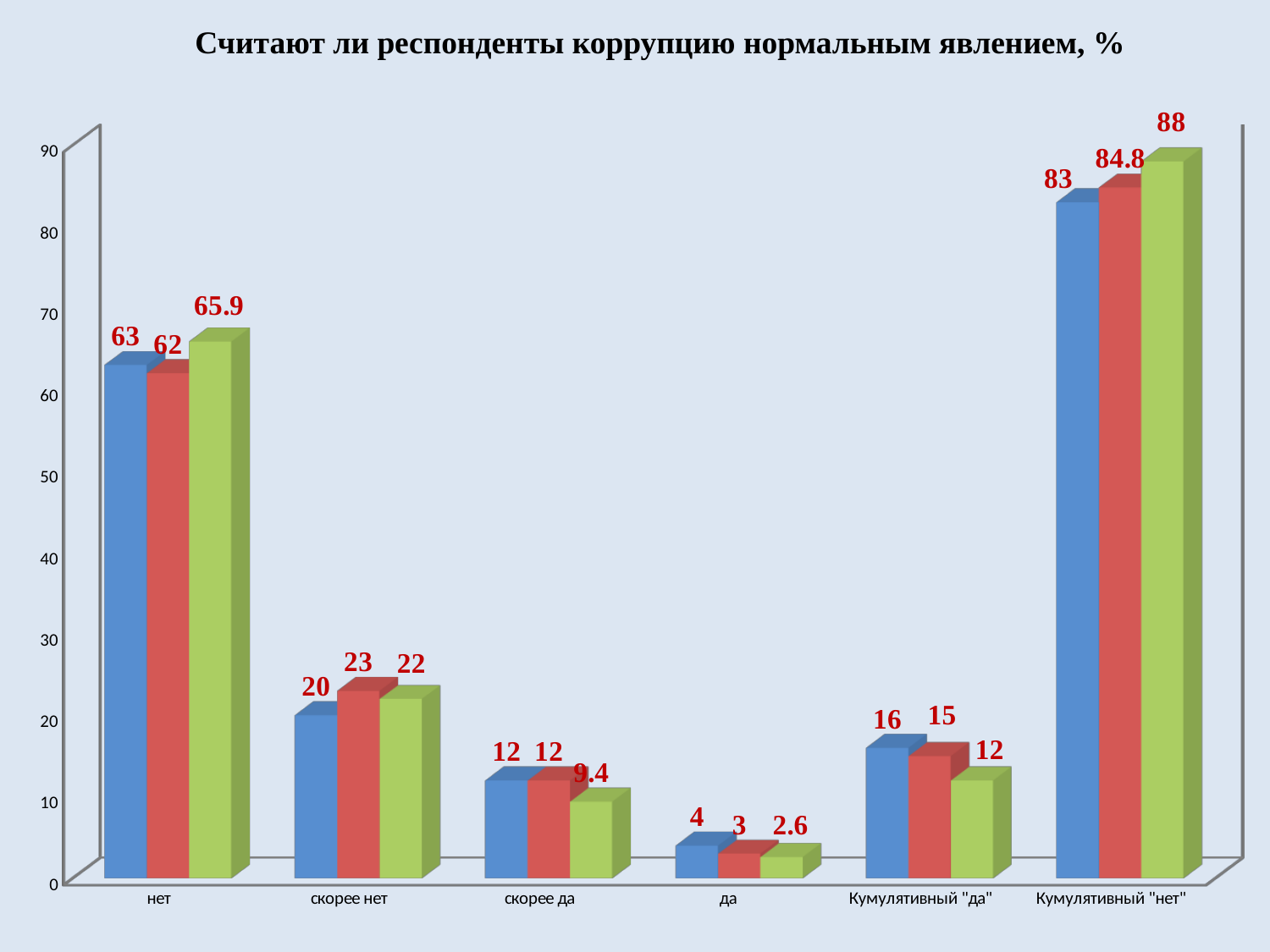
How many categories are shown on the x axis of the chart? 6 What is the value of the green bar for the category "да"? 2.6 Which category has the highest value for the red bars? Кумулятивный "нет" What is the value of the red bar for the category "скорее нет"? 23 What is the value of the green bar for the category "Кумулятивный "нет""? 88 What is the title of the chart? Считают ли респонденты коррупцию нормальным явлением, % What is the difference between the red bar and the blue bar for the category "Кумулятивный "нет""? 1.8 Which category has the lowest value for the blue bars? да What type of chart is shown on the slide? bar chart What is the value of the blue bar for the category "нет"? 63 Which is larger for the category "Кумулятивный "да"": the blue bar or the green bar? the blue bar What is the difference between the green bar and the blue bar for the category "нет"? 2.9